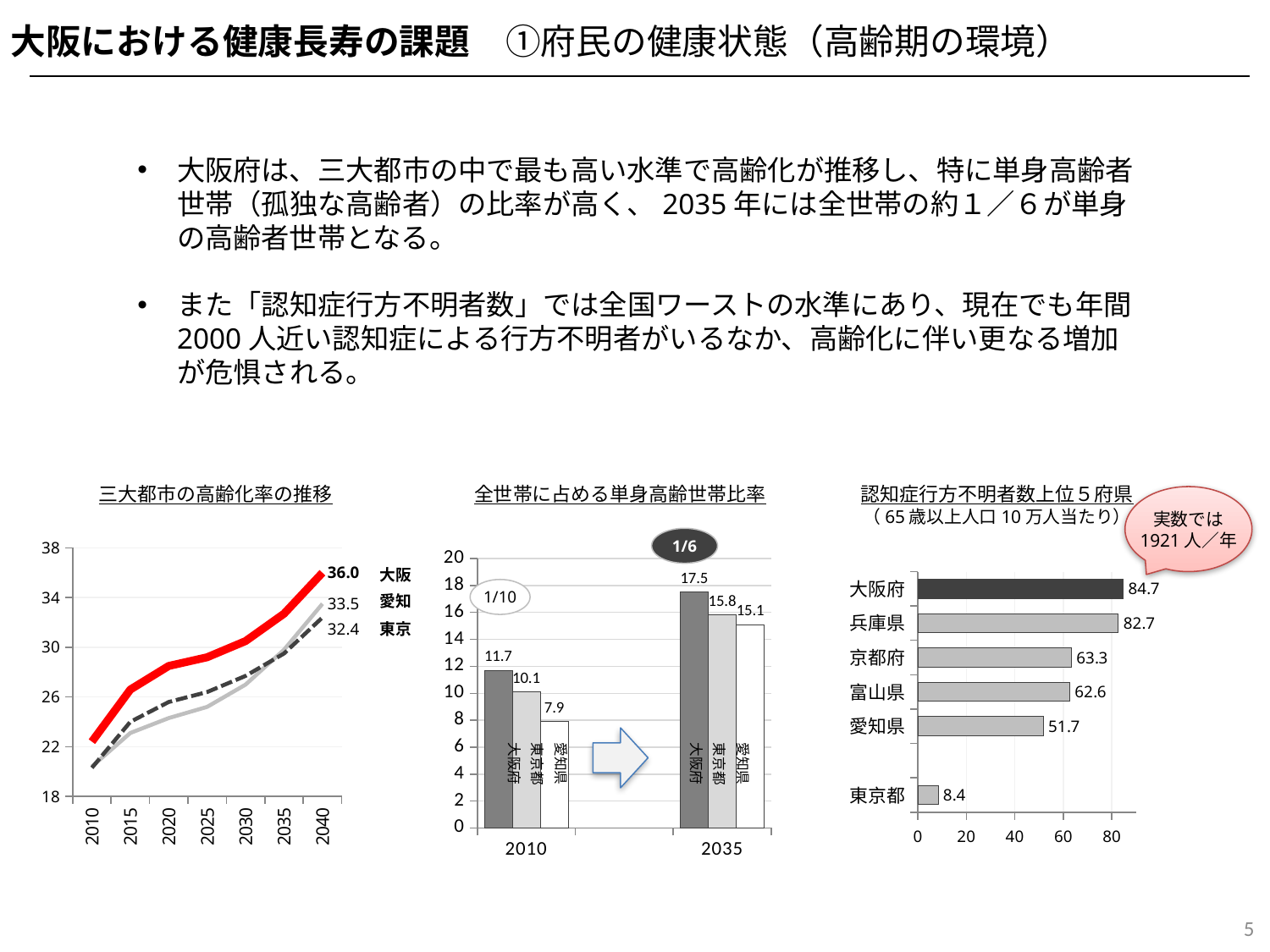
In the chart titled 全世帯に占める単身高齢世帯比率, what is the value for 愛知県 in 2010? 7.9 In the chart titled 認知症行方不明者数上位５府県, which prefecture has the highest value? 大阪府 What kind of chart is the one titled 認知症行方不明者数上位５府県? bar chart In the chart titled 認知症行方不明者数上位５府県, what is the value for 兵庫県? 82.7 In the chart titled 全世帯に占める単身高齢世帯比率, by how much does the value for 大阪府 increase from 2010 to 2035? 5.8 In the chart titled 三大都市の高齢化率の推移, what is the difference between the 2040 values for 大阪 and 東京? 3.6 In the chart titled 全世帯に占める単身高齢世帯比率, which is larger in 2035: 東京都 or 愛知県? 東京都 In the chart titled 三大都市の高齢化率の推移, is the value for 大阪 in 2010 greater or less than 26? less In the chart titled 三大都市の高齢化率の推移, what is the value for 大阪 in 2040? 36.0 In the chart titled 三大都市の高齢化率の推移, which of the three lines has the lowest value in 2040? 東京 In the chart titled 全世帯に占める単身高齢世帯比率, what is the value for 大阪府 in 2035? 17.5 In the chart titled 三大都市の高齢化率の推移, do the lines rise or fall from 2010 to 2040? rise